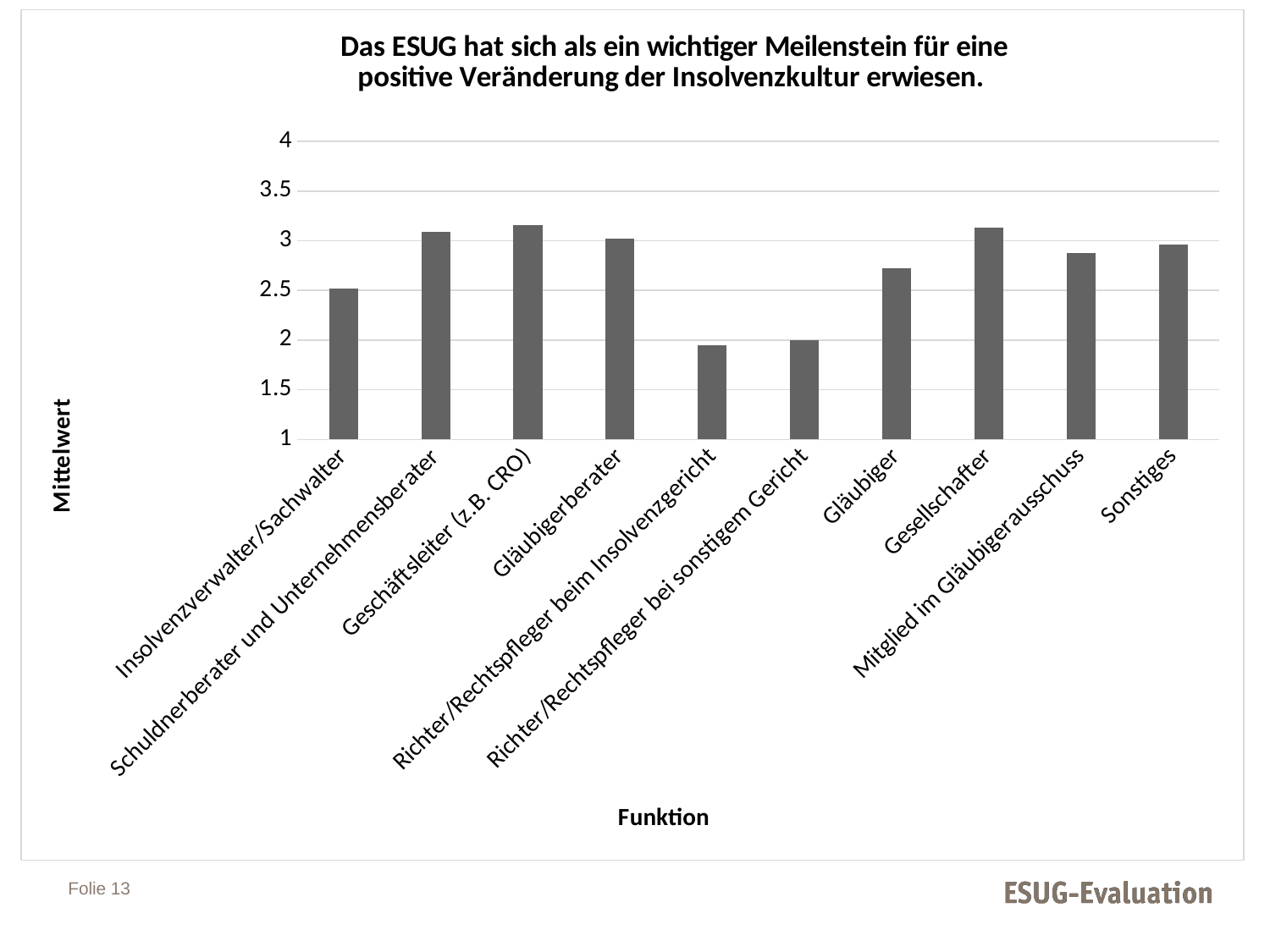
How many categories (Funktionen) are shown on the x axis? 10 Which has the larger value: Gläubiger or Mitglied im Gläubigerausschuss? Mitglied im Gläubigerausschuss What is the label of the y axis? Mittelwert Is the value for Schuldnerberater und Unternehmensberater greater or less than 3? greater What kind of chart is shown on the slide? bar chart Is the value for Insolvenzverwalter/Sachwalter greater or less than 3? less Is the value for Gesellschafter greater or less than 3? greater Which has the larger value: Insolvenzverwalter/Sachwalter or Schuldnerberater und Unternehmensberater? Schuldnerberater und Unternehmensberater What is the label of the x axis? Funktion